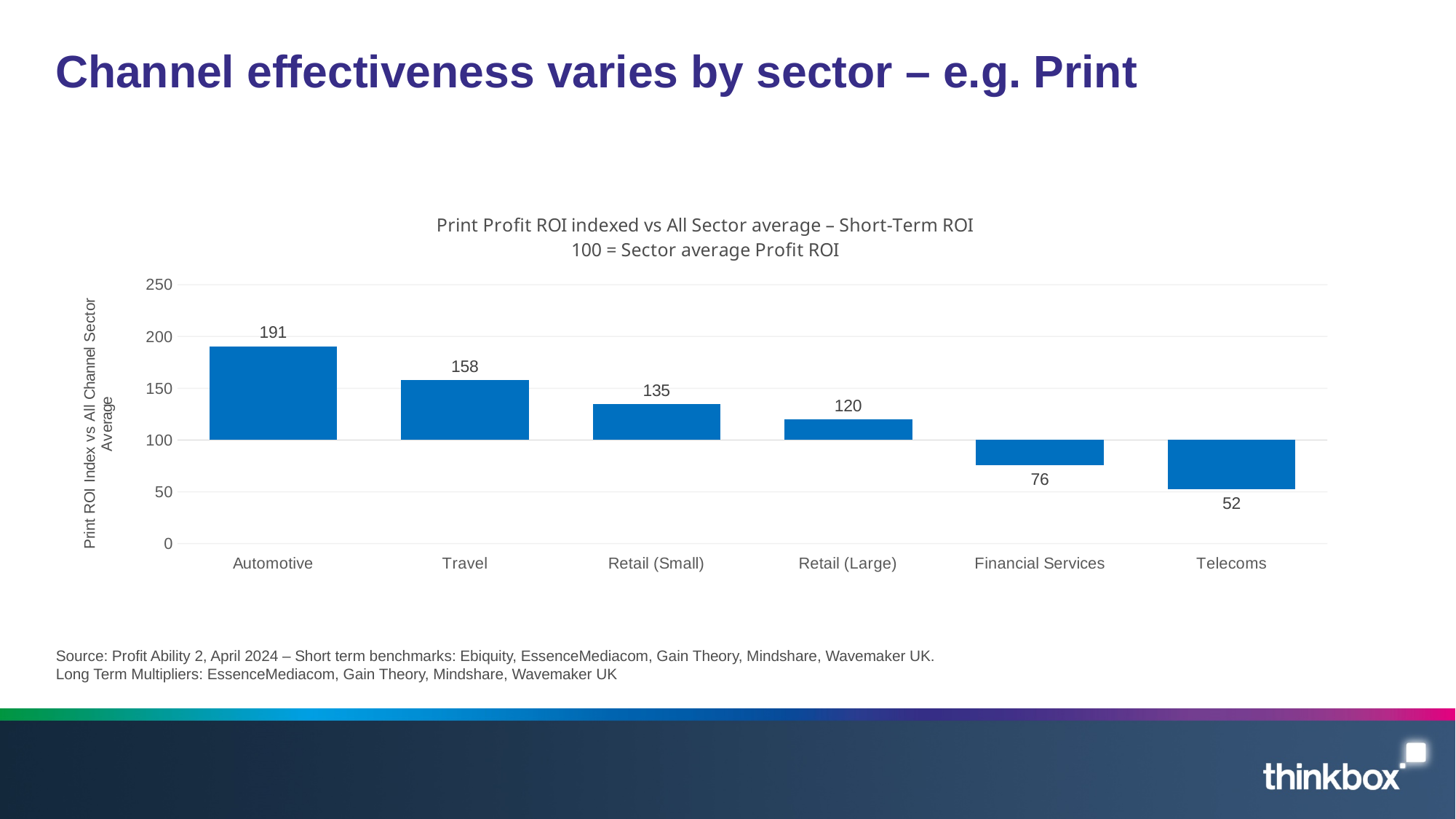
What is the difference between the Print ROI index for Financial Services and Telecoms? 24 Which has a higher Print ROI index, Retail (Small) or Retail (Large)? Retail (Small) What is the Print ROI index value for Telecoms? 52 Do the values rise or fall moving from left to right across the sectors? Fall What is the Print ROI index value for Retail (Large)? 120 How many sectors are shown in the chart? 6 What is the difference between the Print ROI index for Travel and Retail (Small)? 23 Which sector has the highest Print ROI index? Automotive What is the Print ROI index value for Automotive? 191 Which sector has the lowest Print ROI index? Telecoms Is the value for Financial Services greater or less than 100? less What kind of chart is shown on the slide? Bar chart